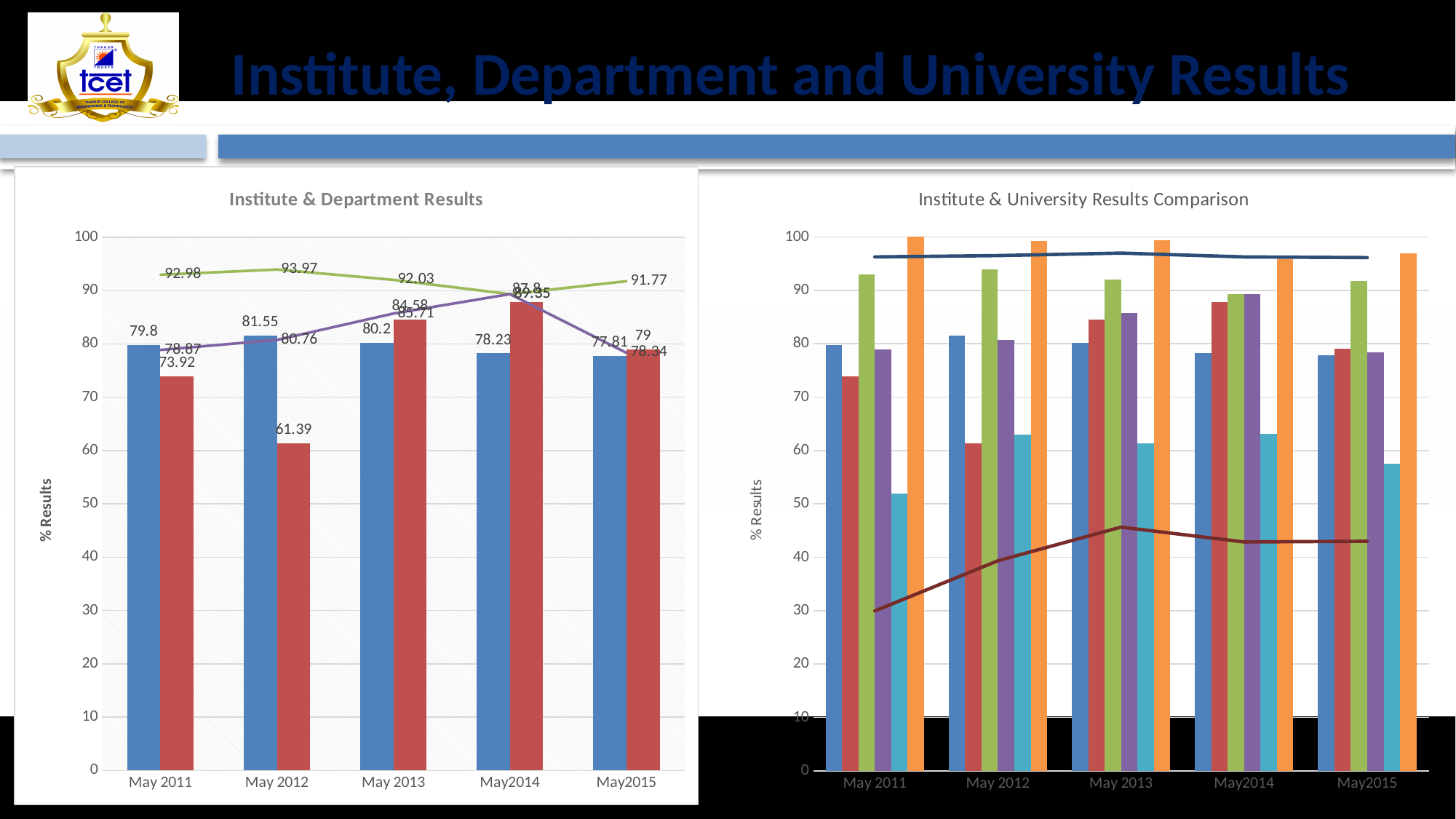
On the 'Institute & Department Results' chart, what is the value of the red bar for May 2012? 61.39 On the 'Institute & Department Results' chart, in which period is the red bar lowest? May 2012 On the 'Institute & Department Results' chart, do the blue bars rise or fall from May 2012 to May2015? fall On the 'Institute & University Results Comparison' chart, is the light blue bar for May 2011 greater or less than 60? less On the 'Institute & Department Results' chart, what is the value of the blue bar for May 2012? 81.55 On the 'Institute & Department Results' chart, what is the difference between the blue bar and the red bar for May 2012? 20.16 On the 'Institute & Department Results' chart, for May 2013, which is larger: the blue bar or the red bar? the red bar On the 'Institute & University Results Comparison' chart, is the orange bar for May 2011 greater or less than 90? greater What kind of chart is the 'Institute & University Results Comparison' chart? bar and line chart On the 'Institute & Department Results' chart, in which period is the blue bar highest? May 2012 How many periods are shown on the x axis of the 'Institute & Department Results' chart? 5 On the 'Institute & Department Results' chart, what is the value of the green line at May 2012? 93.97